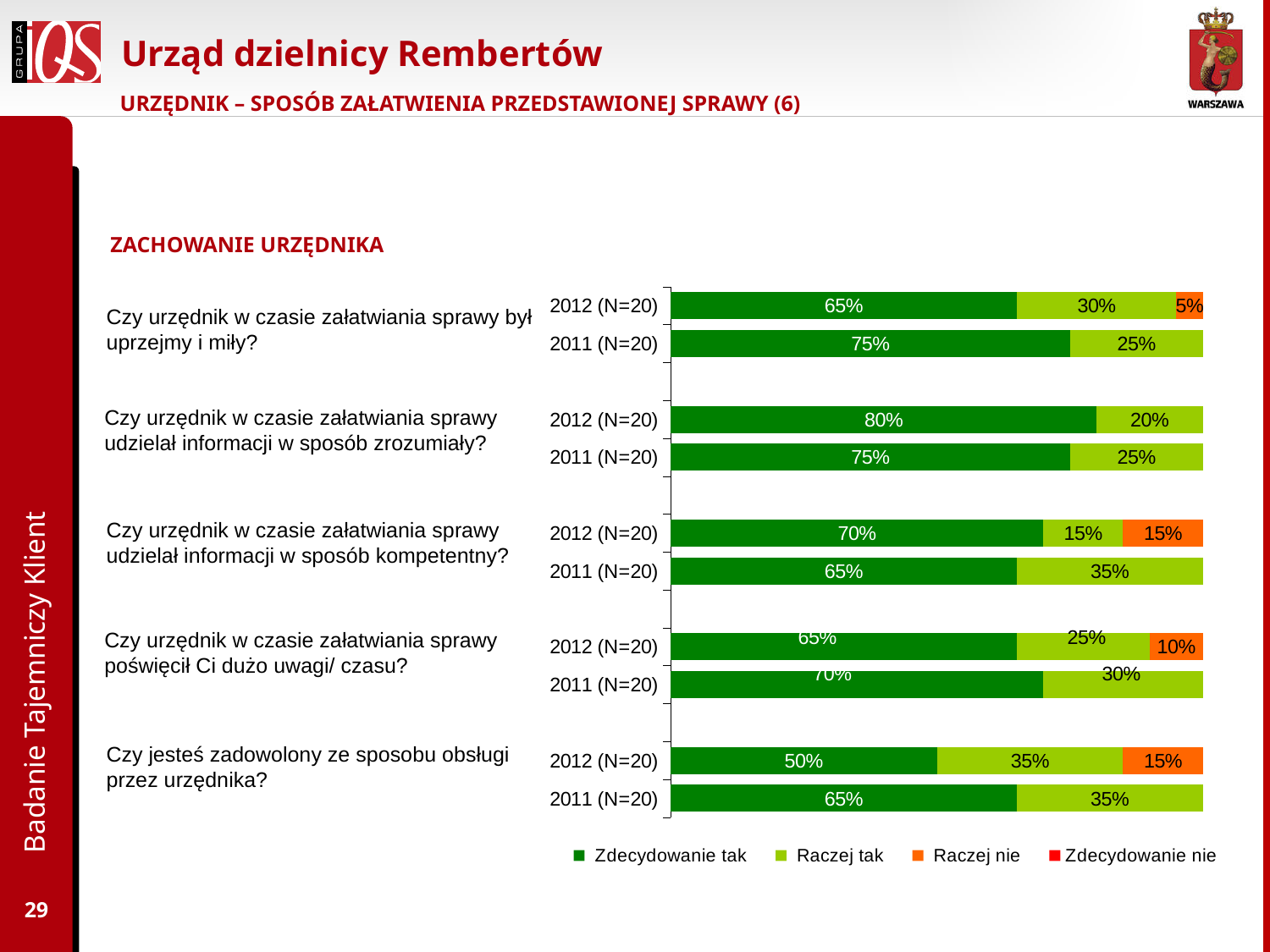
Which bar has the lowest 'Zdecydowanie tak' share on the chart? 2012 (N=20) for 'Czy jesteś zadowolony ze sposobu obsługi przez urzędnika?' What is the 'Raczej tak' value for 2012 (N=20) for the question 'Czy jesteś zadowolony ze sposobu obsługi przez urzędnika?' 35% How many survey questions are shown on the chart? 5 How many series does the chart legend list? 4 What type of chart is shown on the slide? Stacked bar chart For the question 'Czy urzędnik w czasie załatwiania sprawy udzielał informacji w sposób kompetentny?', which year has the larger 'Zdecydowanie tak' share, 2012 or 2011? 2012 Which question has the highest 'Zdecydowanie tak' share in 2012 (N=20)? Czy urzędnik w czasie załatwiania sprawy udzielał informacji w sposób zrozumiały? What is the 'Zdecydowanie tak' value for 2012 (N=20) for the question 'Czy urzędnik w czasie załatwiania sprawy był uprzejmy i miły?' 65% For the question 'Czy urzędnik w czasie załatwiania sprawy udzielał informacji w sposób zrozumiały?', what is the difference in 'Zdecydowanie tak' between 2012 and 2011? 5 percentage points What sample size (N) is given for each bar on the chart? N=20 What is the 'Raczej nie' value for 2012 (N=20) for the question 'Czy urzędnik w czasie załatwiania sprawy udzielał informacji w sposób kompetentny?' 15% What is the 'Zdecydowanie tak' value for 2012 (N=20) for the question 'Czy urzędnik w czasie załatwiania sprawy udzielał informacji w sposób zrozumiały?' 80%